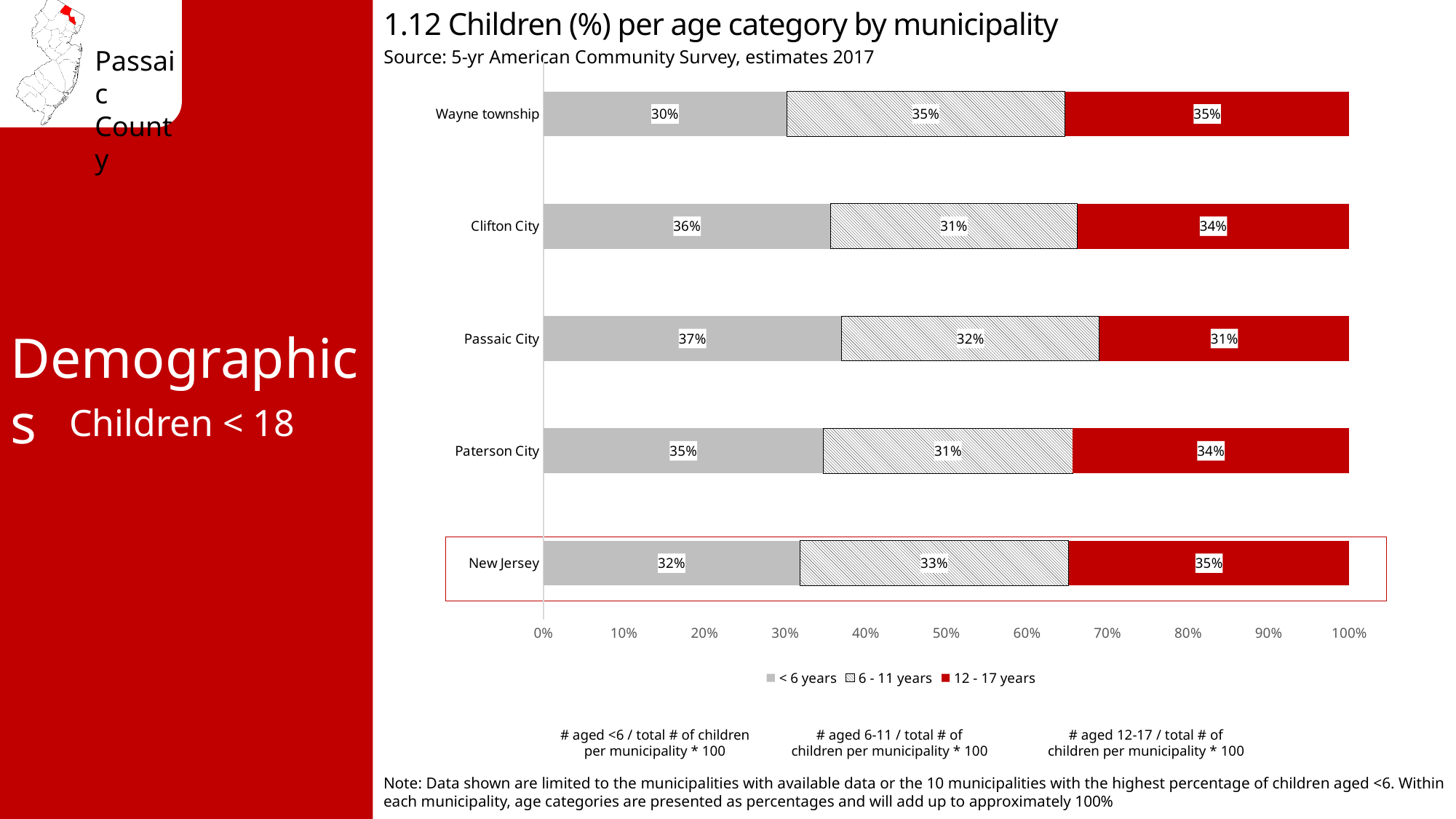
Which series is shown in red? 12 - 17 years What is the value for the 12 - 17 years series for Passaic City? 31% Which is larger: the 12 - 17 years share for Wayne township or for Passaic City? Wayne township What percentage of children in New Jersey are aged 6 - 11 years? 33% Which municipality has the highest percentage of children under 6 years? Passaic City What is the total of the stacked bar for Clifton City? 101% How many series does the legend list? 3 What kind of chart is shown on the slide? Stacked bar chart Which municipality has the lowest percentage of children under 6 years? Wayne township What percentage of children in Wayne township are under 6 years old? 30% How many municipalities or regions are shown on the chart? 5 What is the difference between the < 6 years percentage for Passaic City and for Wayne township? 7%